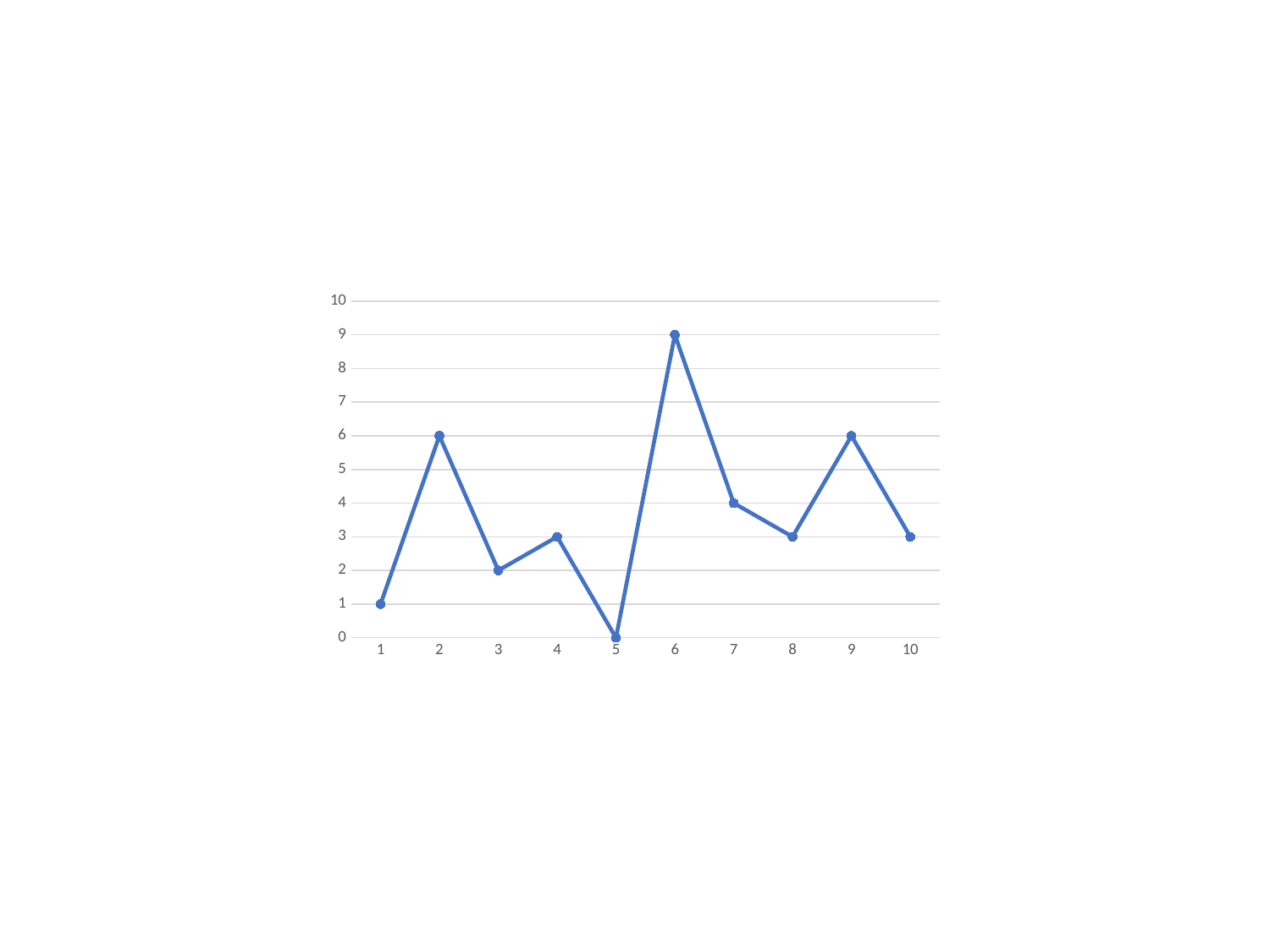
What is the value at x = 10? 3 At which x value does the line reach its lowest point? 5 What is the maximum value shown on the vertical axis? 10 What is the value at x = 6? 9 What is the value at x = 2? 6 What is the value at x = 5? 0 What is the difference between the values at x = 6 and x = 7? 5 What kind of chart is shown on the slide? line chart Which is larger, the value at x = 4 or the value at x = 9? x = 9 At which x value does the line reach its highest point? 6 How many data points are plotted on the line? 10 Does the line rise or fall between x = 4 and x = 5? fall